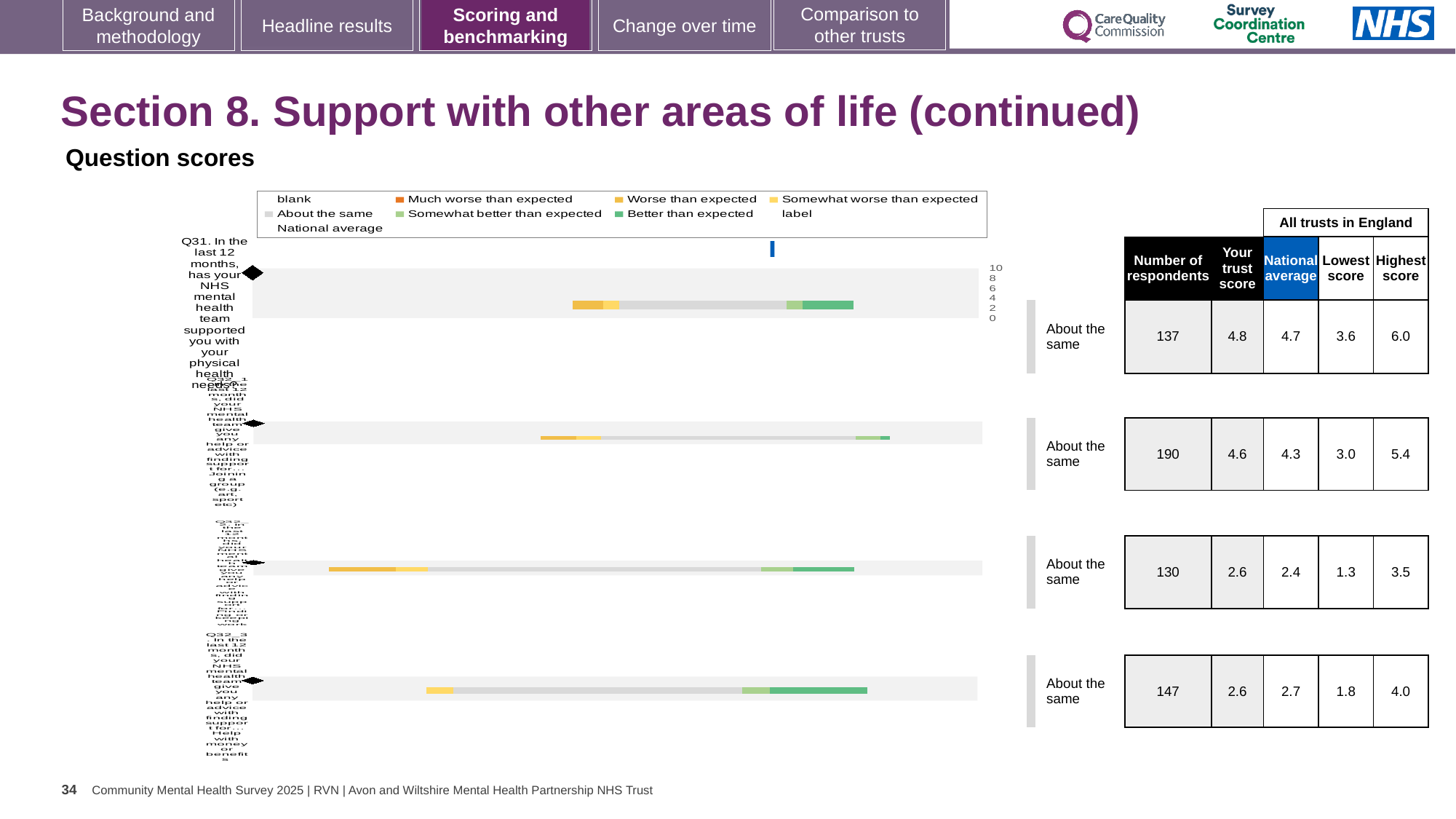
How many entries does the chart legend list? 9 What is the heading above the chart? Question scores What is the trust score for Q31 (the first bar)? 4.8 How many question bars are plotted in the chart? 4 What benchmark label is shown for Q31 (the first bar)? About the same What kind of chart is shown on the slide? Bar chart What is the national average for Q31 (the first bar)? 4.7 What is the number of respondents for Q31 (the first bar)? 137 For the fourth bar, which is larger: the trust score or the national average? National average (2.7) Which bar has the highest number of respondents? The second bar (190) What is the highest score in England for Q31 (the first bar)? 6.0 What is the difference between the trust score and the national average for Q31? 0.1